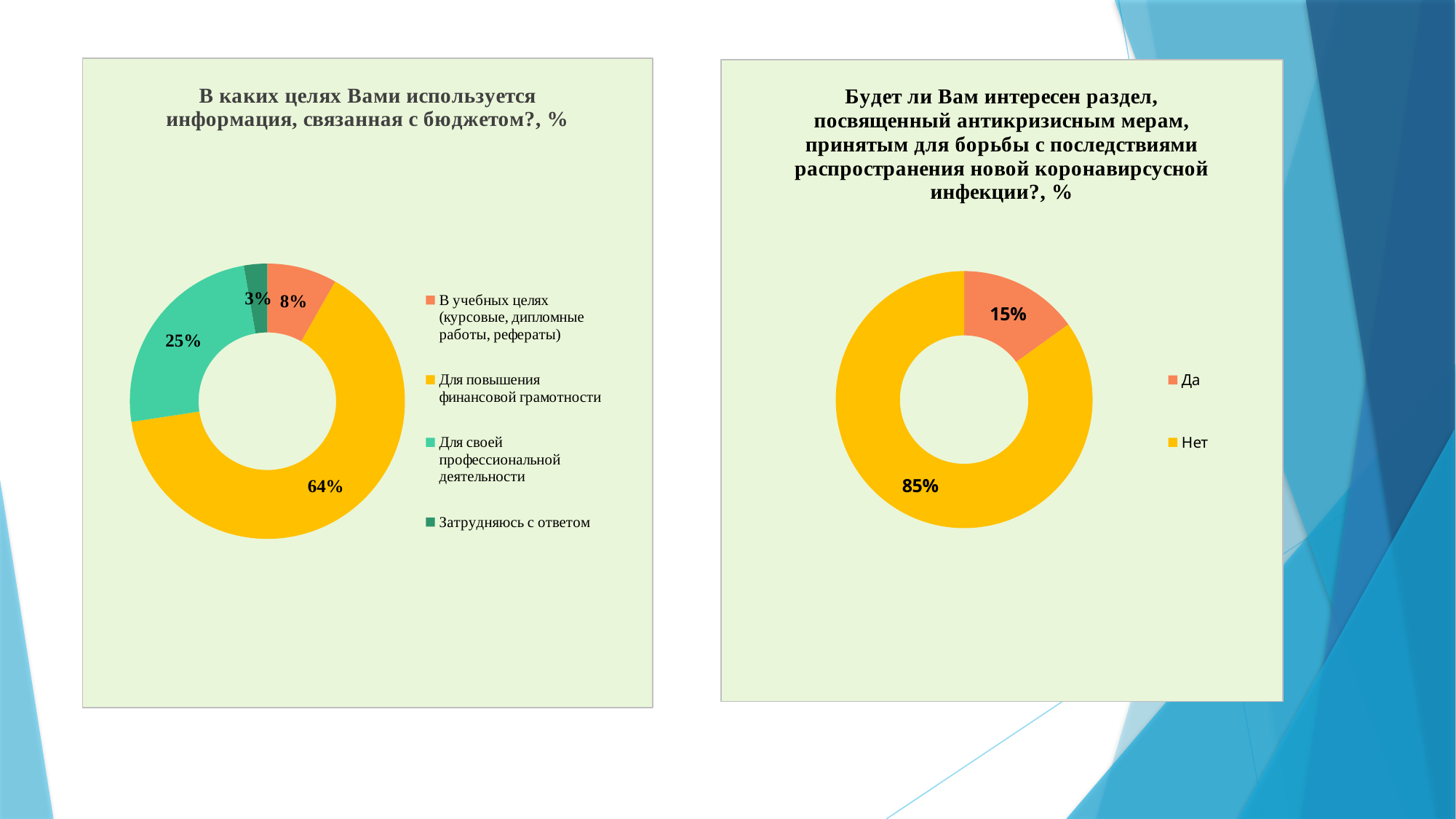
In the right chart, what is the difference between 'Нет' and 'Да'? 70% In the left chart (В каких целях Вами используется информация, связанная с бюджетом?), what is the value for 'Для повышения финансовой грамотности'? 64% In the right chart (Будет ли Вам интересен раздел, посвященный антикризисным мерам...), what is the value for 'Да'? 15% In the right chart, which is larger, 'Да' or 'Нет'? Нет In the left chart, which category has the largest share? Для повышения финансовой грамотности In the left chart, which category has the smallest share? Затрудняюсь с ответом What kind of chart is the left chart? Doughnut (pie) chart In the left chart, what is the value for 'Затрудняюсь с ответом'? 3% In the right chart, what is the value for 'Нет'? 85% In the left chart, what is the value for 'В учебных целях (курсовые, дипломные работы, рефераты)'? 8% In the left chart, what is the difference between 'Для повышения финансовой грамотности' and 'Для своей профессиональной деятельности'? 39% In the left chart, how many categories are shown? 4